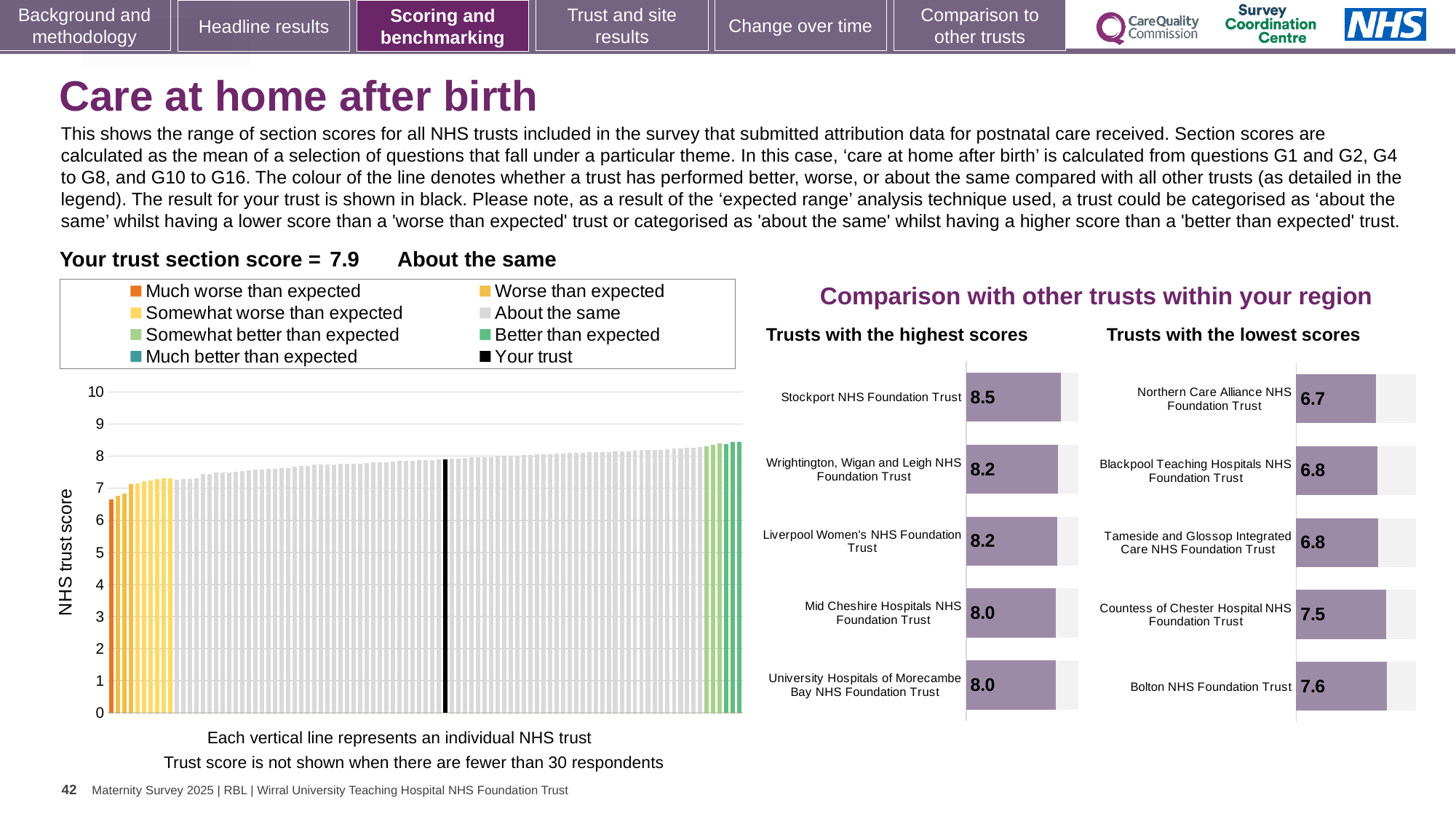
How many entries does the legend above the 'NHS trust score' chart list? 8 In the 'Trusts with the lowest scores' chart, what is the score for Northern Care Alliance NHS Foundation Trust? 6.7 In the 'NHS trust score' chart on the left, do the values rise or fall from left to right? Rise What is the difference between Stockport NHS Foundation Trust's score in the 'Trusts with the highest scores' chart and Northern Care Alliance NHS Foundation Trust's score in the 'Trusts with the lowest scores' chart? 1.8 In the 'Trusts with the highest scores' chart, what is the score for Stockport NHS Foundation Trust? 8.5 In the 'Trusts with the highest scores' chart, what is the score for Mid Cheshire Hospitals NHS Foundation Trust? 8.0 In the 'Trusts with the highest scores' chart, which trust has the highest score? Stockport NHS Foundation Trust In the 'Trusts with the lowest scores' chart, what is the score for Bolton NHS Foundation Trust? 7.6 In the 'Trusts with the lowest scores' chart, which trust has the lowest score? Northern Care Alliance NHS Foundation Trust In the 'Trusts with the lowest scores' chart, which has the larger score: Countess of Chester Hospital NHS Foundation Trust or Blackpool Teaching Hospitals NHS Foundation Trust? Countess of Chester Hospital NHS Foundation Trust What kind of chart is the 'NHS trust score' chart on the left of the slide? Bar chart How many trusts are shown in the 'Trusts with the highest scores' chart? 5